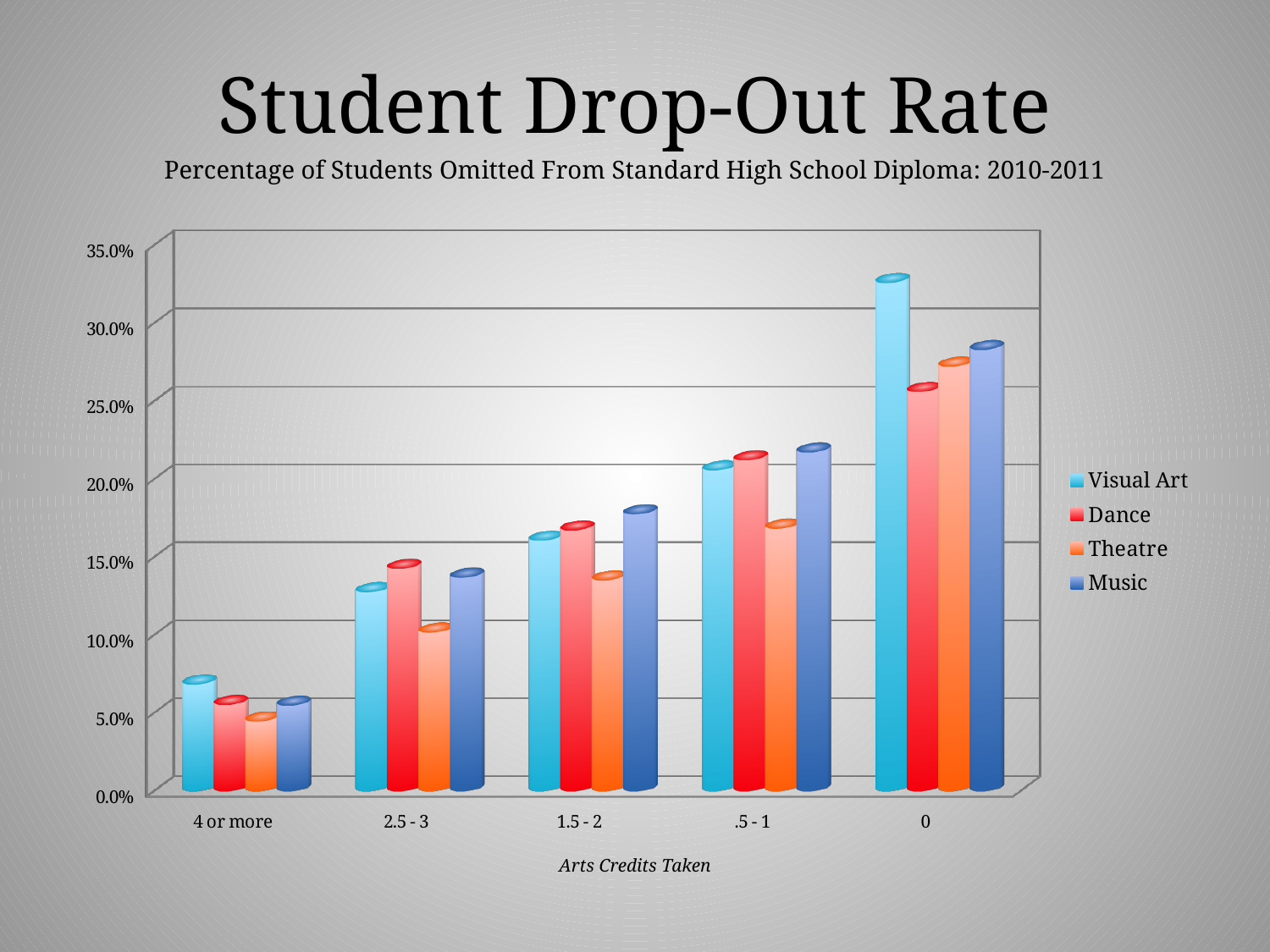
How many categories of Arts Credits Taken are shown on the x axis? 5 Is the Theatre value for '2.5 - 3' credits greater or less than 15.0%? less Which series and category has the tallest bar in the chart? Visual Art, 0 credits How many series does the legend list? 4 What is the title of the x axis? Arts Credits Taken Do the Visual Art values rise or fall moving from '4 or more' to 0 credits along the x axis? rise Which series has the lowest bar in the '4 or more' category? Theatre In the 0 credits category, which is larger: Visual Art or Dance? Visual Art Is the Music value for '.5 - 1' credits greater or less than 20.0%? greater Is the Visual Art value for 0 credits greater or less than 30.0%? greater What kind of chart is shown on the slide? Bar chart In the '1.5 - 2' category, which is larger: Music or Theatre? Music